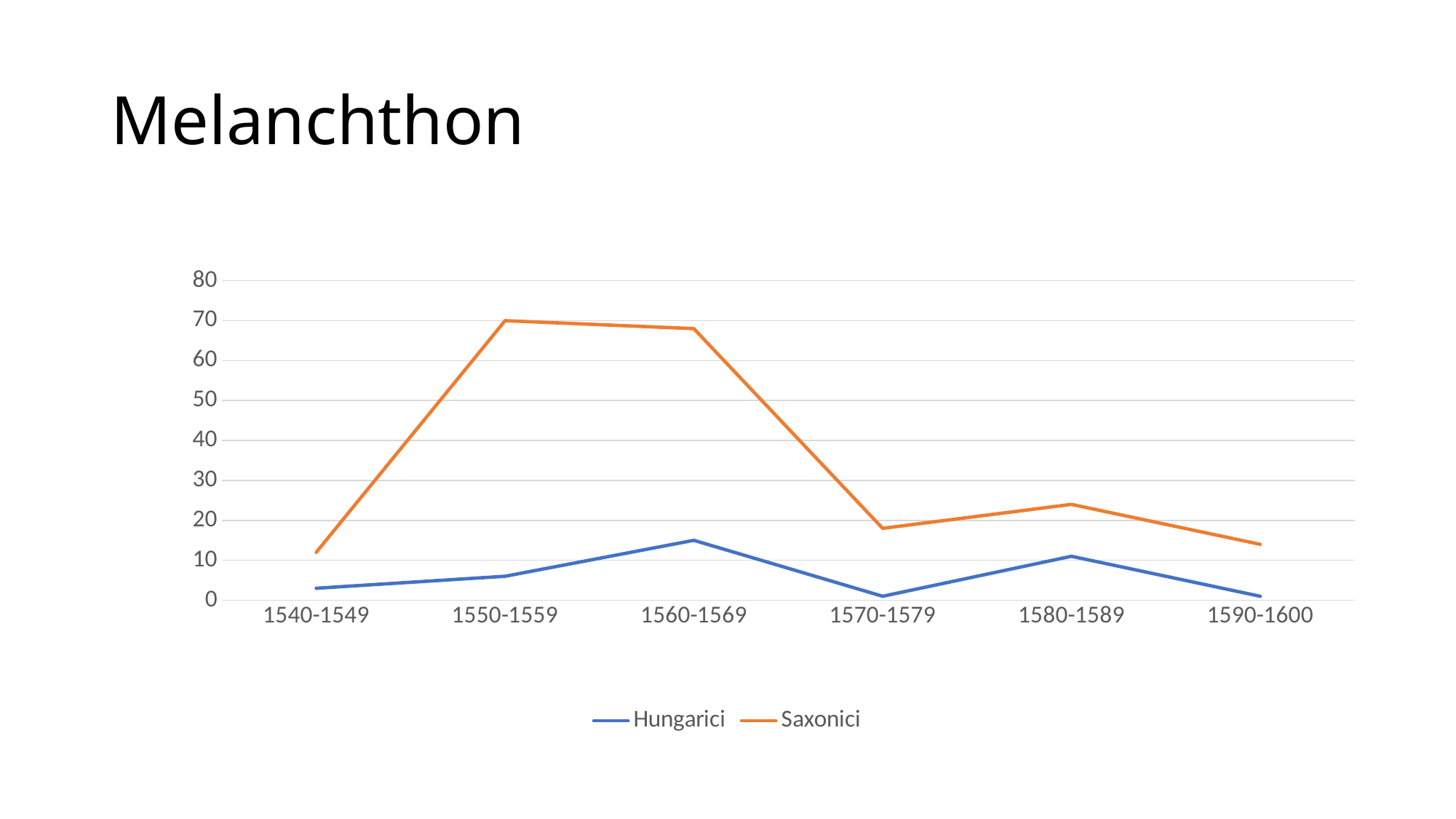
What kind of chart is shown on the slide? line chart What is the title of the slide containing the chart? Melanchthon Which series has the larger value in 1550-1559, Hungarici or Saxonici? Saxonici In which period does the Hungarici series reach its highest value? 1560-1569 How many time periods are shown on the x axis? 6 Is the value for Saxonici in 1570-1579 greater or less than 20? less Does the Saxonici series rise or fall from 1560-1569 to 1570-1579? fall Is the value for Hungarici in 1570-1579 greater or less than 10? less How many series does the legend list? 2